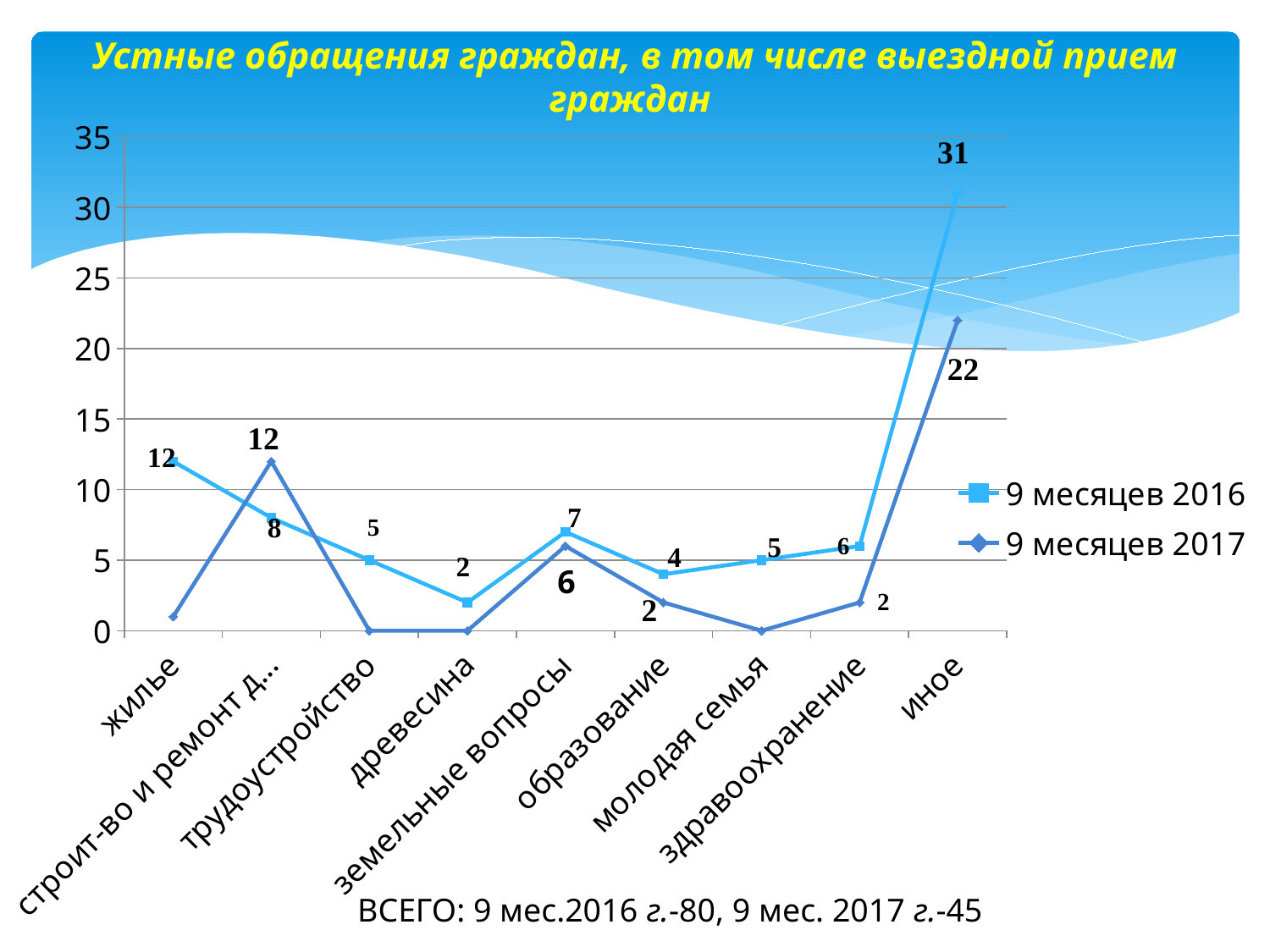
Which category has the highest value in the 9 месяцев 2016 series? иное For образование, which series has the larger value, 9 месяцев 2016 or 9 месяцев 2017? 9 месяцев 2016 What kind of chart is shown on the slide? line chart What is the value for земельные вопросы in the 9 месяцев 2017 series? 6 What is the value for иное in the 9 месяцев 2017 series? 22 How many series does the legend list? 2 What is the value for жилье in the 9 месяцев 2016 series? 12 What is the difference between the 9 месяцев 2016 and 9 месяцев 2017 values for иное? 9 What is the value for иное in the 9 месяцев 2016 series? 31 Is the value for жилье in the 9 месяцев 2017 series greater or less than 5? less Which category has the lowest value in the 9 месяцев 2016 series? древесина How many categories are shown on the x axis? 9